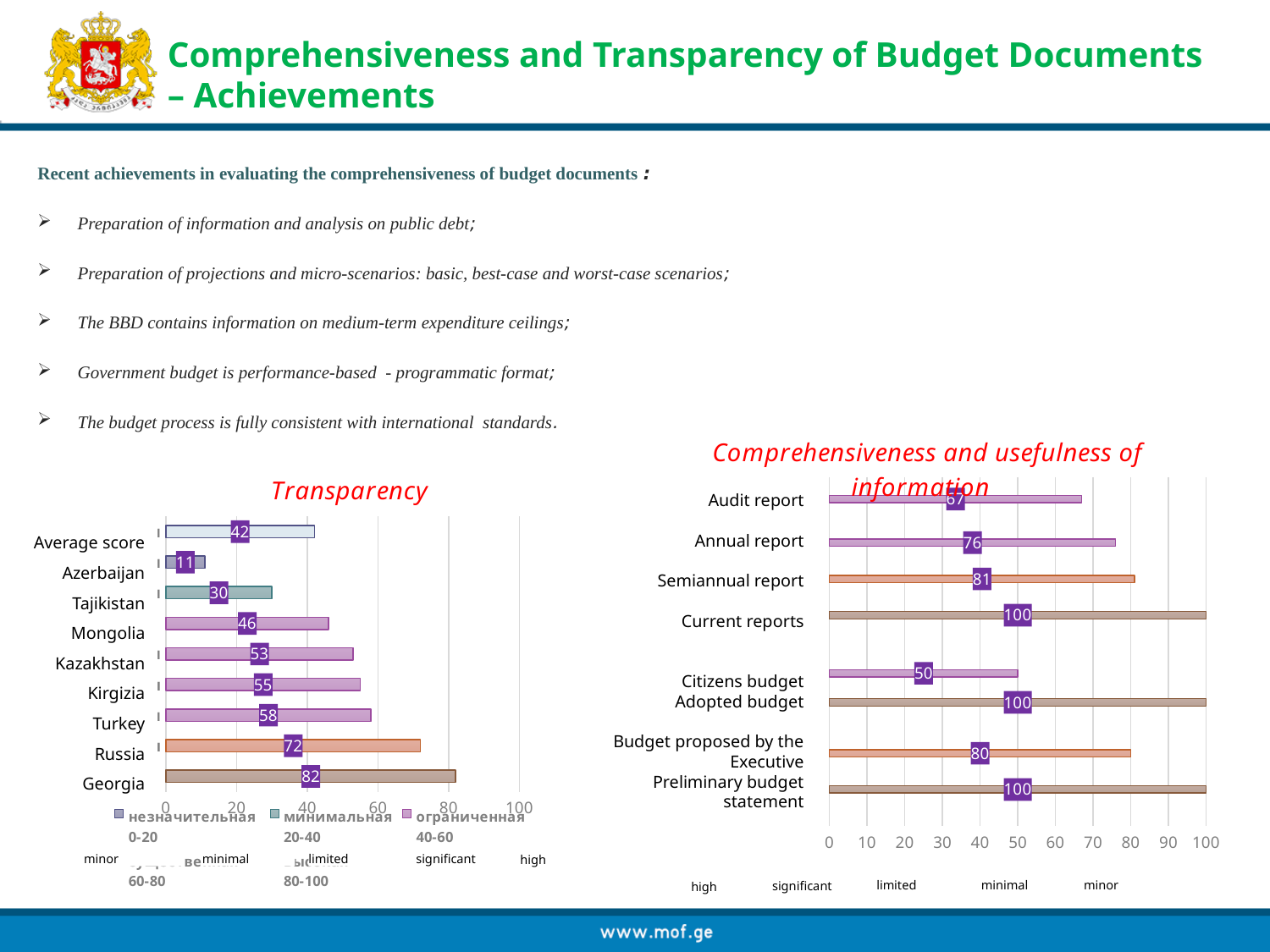
In the Transparency chart, what is the value for Azerbaijan? 11 In the Transparency chart, which has the larger value, Turkey or Kazakhstan? Turkey In the Transparency chart, what is the difference between the values for Georgia and Russia? 10 In the Comprehensiveness and usefulness of information chart, what is the value for Annual report? 76 In the Transparency chart, what is the Average score? 42 In the Transparency chart, what is the value for Georgia? 82 How many categories are plotted in the Transparency chart? 9 In the Comprehensiveness and usefulness of information chart, what is the value for Citizens budget? 50 In the Transparency chart, which country has the highest value? Georgia What kind of chart is the Comprehensiveness and usefulness of information chart? Bar chart In the Comprehensiveness and usefulness of information chart, which category has the lowest value? Citizens budget In the Transparency chart, which country has the lowest value? Azerbaijan